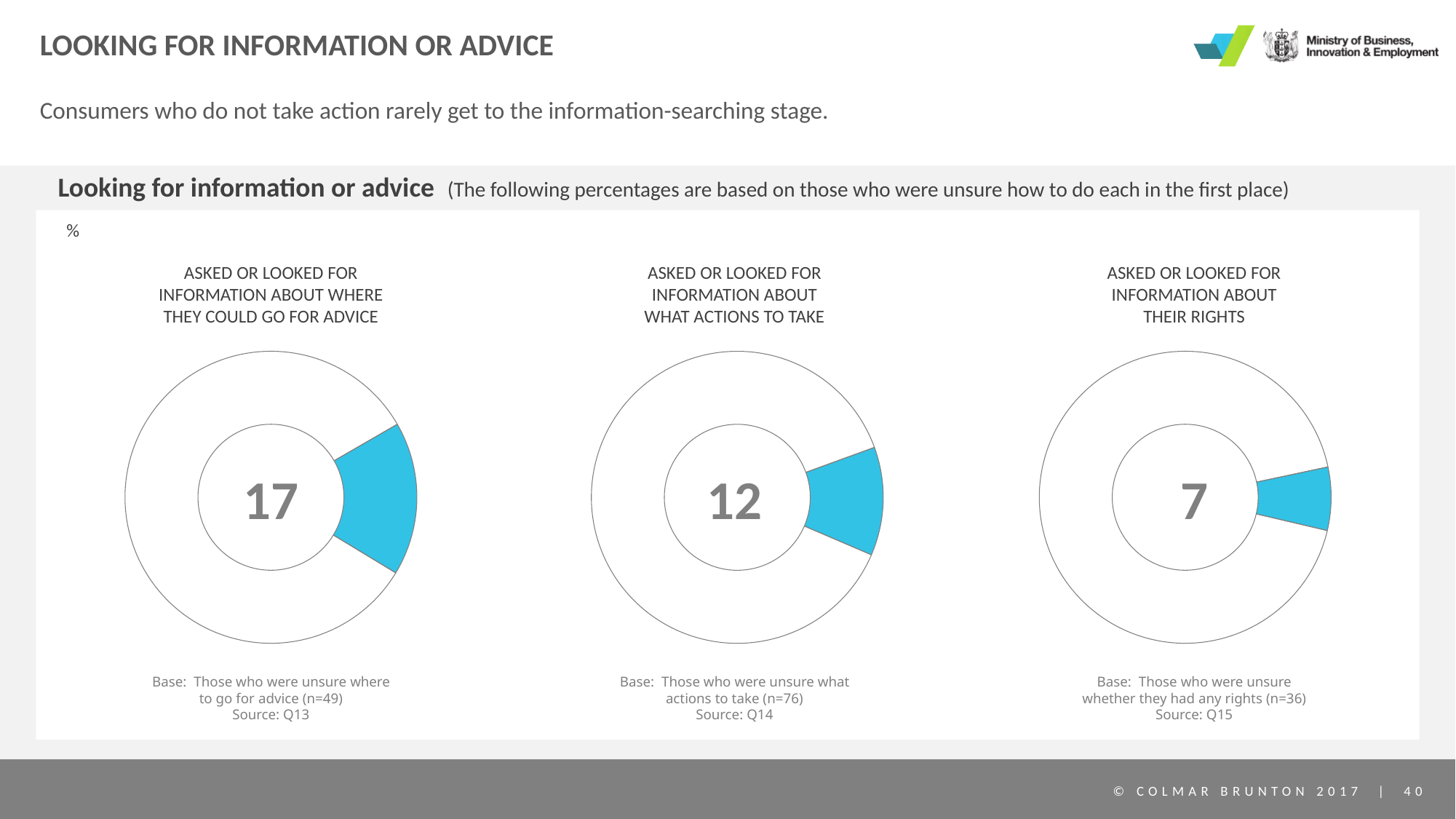
What is the base size (n) for the chart about looking for information about what actions to take? n=76 What is the source question for the chart about looking for information about their rights? Q15 How many donut charts are shown on the slide? 3 What kind of chart is used to show each percentage on the slide? Donut chart What percentage asked or looked for information about their rights? 7 Which is larger: the percentage who looked for information about where to go for advice or the percentage who looked for information about what actions to take? Where to go for advice Which of the three information-seeking behaviours has the highest percentage? Asked or looked for information about where they could go for advice What is the difference in percentage points between looking for information about what actions to take and looking for information about their rights? 5 What percentage asked or looked for information about what actions to take? 12 What percentage of those unsure where to go for advice asked or looked for information about where they could go for advice? 17 Which of the three information-seeking behaviours has the lowest percentage? Asked or looked for information about their rights What is the difference in percentage points between those who looked for information about where to go for advice and those who looked for information about their rights? 10